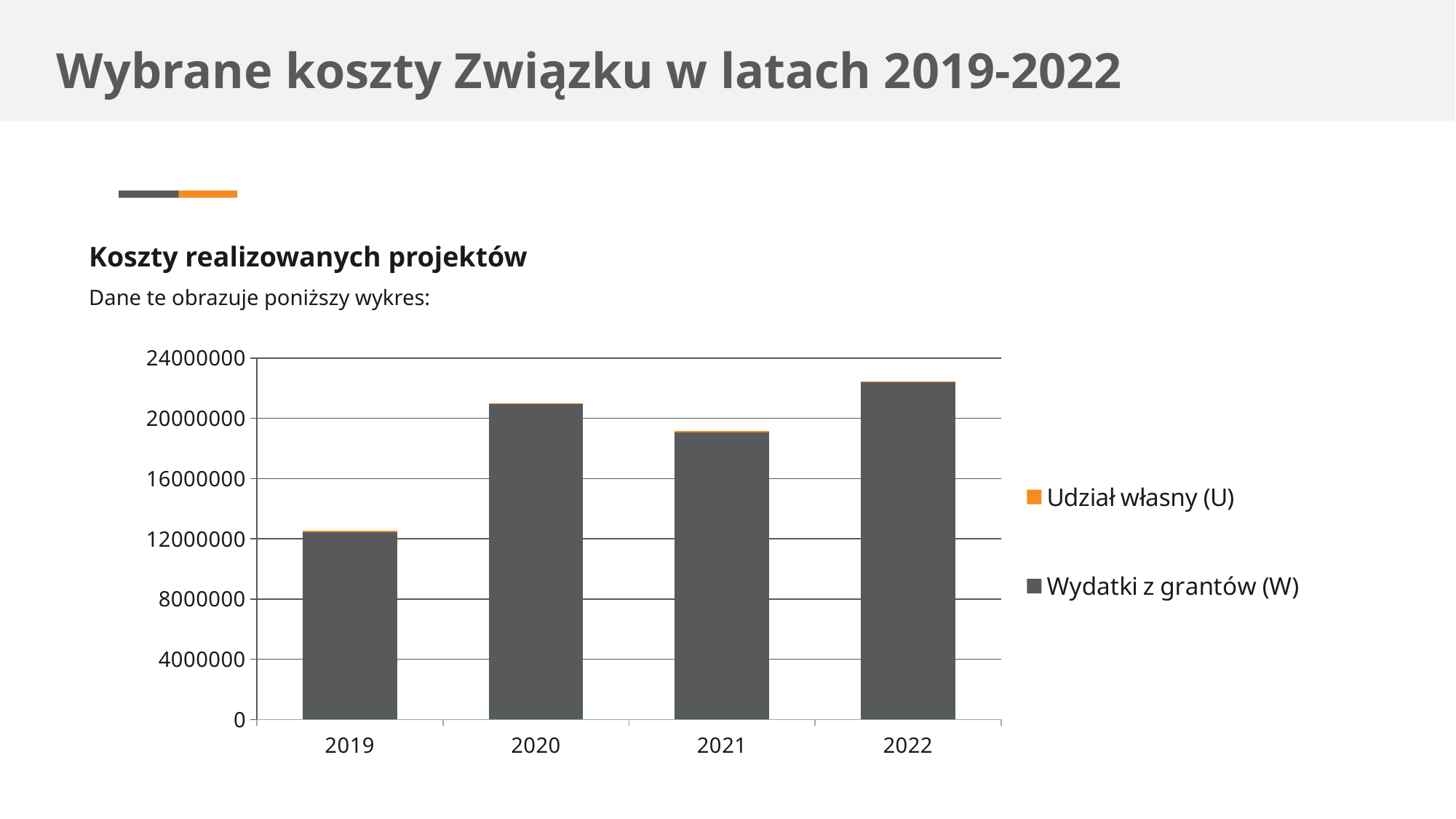
Is the total bar for 2022 greater or less than 20000000? greater What kind of chart is shown on the slide? bar chart How many years are shown on the x axis of the chart? 4 Which year has the highest total bar? 2022 Is the total bar for 2020 greater or less than 20000000? greater Which series makes up almost all of each bar, Udział własny (U) or Wydatki z grantów (W)? Wydatki z grantów (W) What colour represents the series Udział własny (U) in the legend? orange Is the total bar for 2019 greater or less than 16000000? less Which year has a taller total bar, 2020 or 2021? 2020 How many series does the chart legend list? 2 Which year has the lowest total bar? 2019